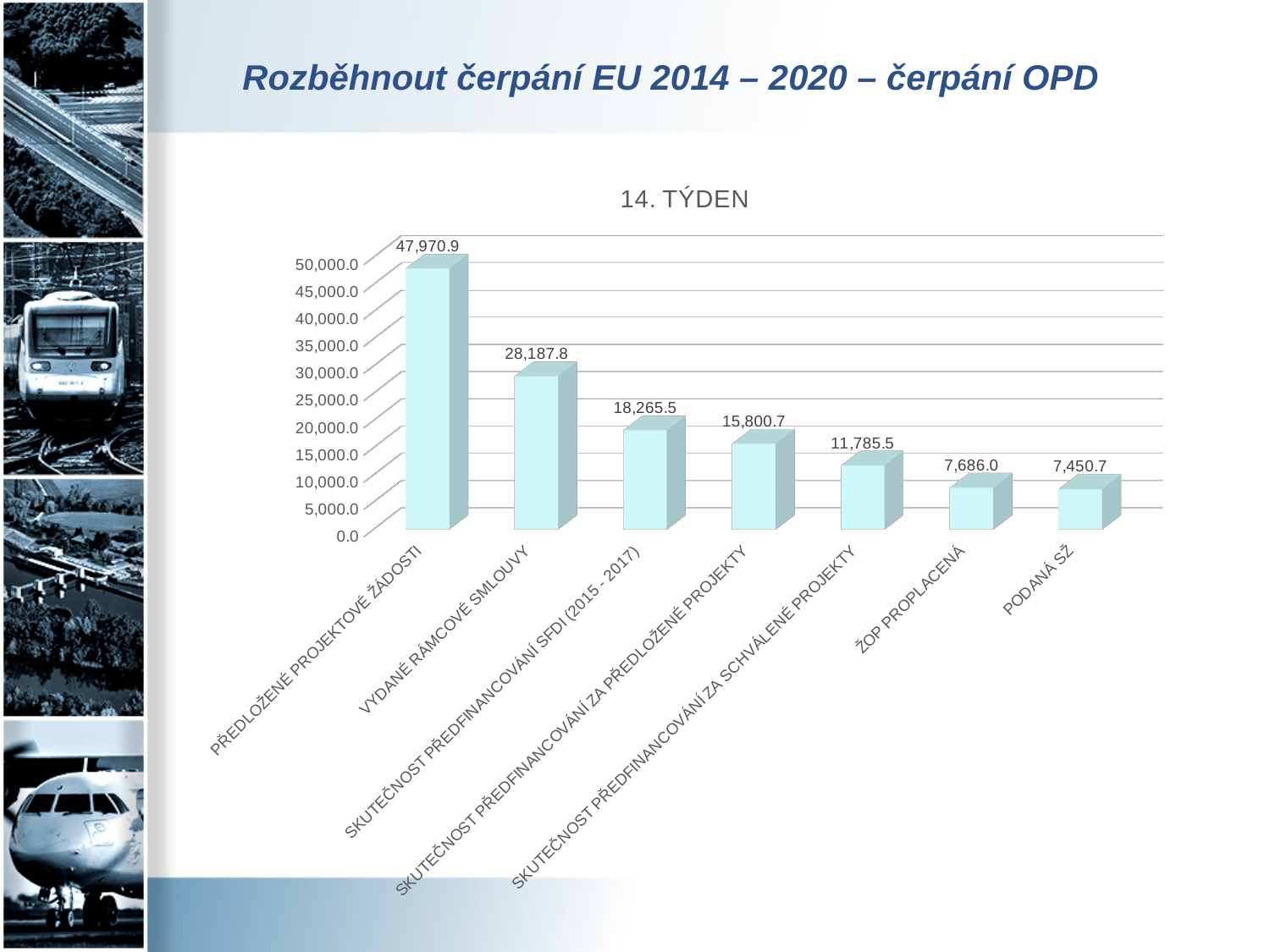
Which category has the highest value? PŘEDLOŽENÉ PROJEKTOVÉ ŽÁDOSTI How many categories are shown in the chart? 7 What is the value for PŘEDLOŽENÉ PROJEKTOVÉ ŽÁDOSTI? 47,970.9 What is the value for ŽOP PROPLACENÁ? 7,686.0 What is the difference between the values for PŘEDLOŽENÉ PROJEKTOVÉ ŽÁDOSTI and VYDANÉ RÁMCOVÉ SMLOUVY? 19,783.1 What is the difference between the values for ŽOP PROPLACENÁ and PODANÁ SŽ? 235.3 Which category has the lowest value? PODANÁ SŽ What is the value for SKUTEČNOST PŘEDFINANCOVÁNÍ ZA SCHVÁLENÉ PROJEKTY? 11,785.5 What kind of chart is shown on the slide? Bar chart What is the value for VYDANÉ RÁMCOVÉ SMLOUVY? 28,187.8 Which is larger: SKUTEČNOST PŘEDFINANCOVÁNÍ SFDI (2015 - 2017) or SKUTEČNOST PŘEDFINANCOVÁNÍ ZA PŘEDLOŽENÉ PROJEKTY? SKUTEČNOST PŘEDFINANCOVÁNÍ SFDI (2015 - 2017) What is the title of the chart? 14. TÝDEN